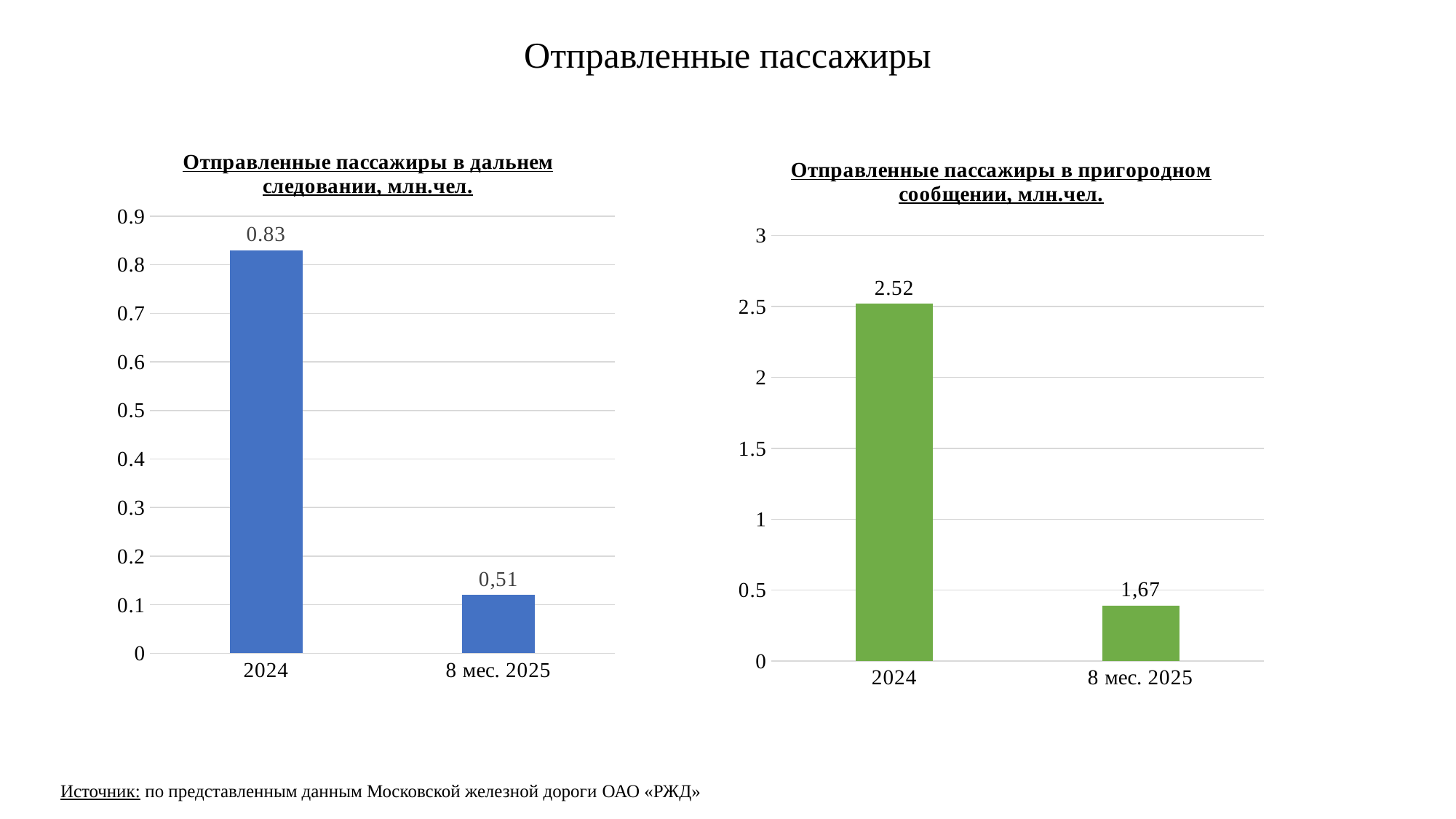
On the chart 'Отправленные пассажиры в дальнем следовании, млн.чел.', what is the value for 8 мес. 2025? 0,51 On the left chart (дальнем следовании), is the value for 2024 greater or less than 0.5? greater What type of chart is the left chart (дальнем следовании)? bar chart On the right chart (пригородном сообщении), which category has the lowest value? 8 мес. 2025 On the left chart (дальнем следовании), which category has the highest value? 2024 On the left chart (дальнем следовании), do the values rise or fall from 2024 to 8 мес. 2025? fall On the chart 'Отправленные пассажиры в дальнем следовании, млн.чел.', what is the value for 2024? 0.83 How many categories are shown on the chart 'Отправленные пассажиры в пригородном сообщении, млн.чел.'? 2 On the right chart (пригородном сообщении), which is larger: the value for 2024 or for 8 мес. 2025? 2024 On the chart 'Отправленные пассажиры в пригородном сообщении, млн.чел.', what is the value for 8 мес. 2025? 1,67 On the right chart (пригородном сообщении), is the value for 2024 greater or less than 2? greater On the chart 'Отправленные пассажиры в пригородном сообщении, млн.чел.', what is the value for 2024? 2.52